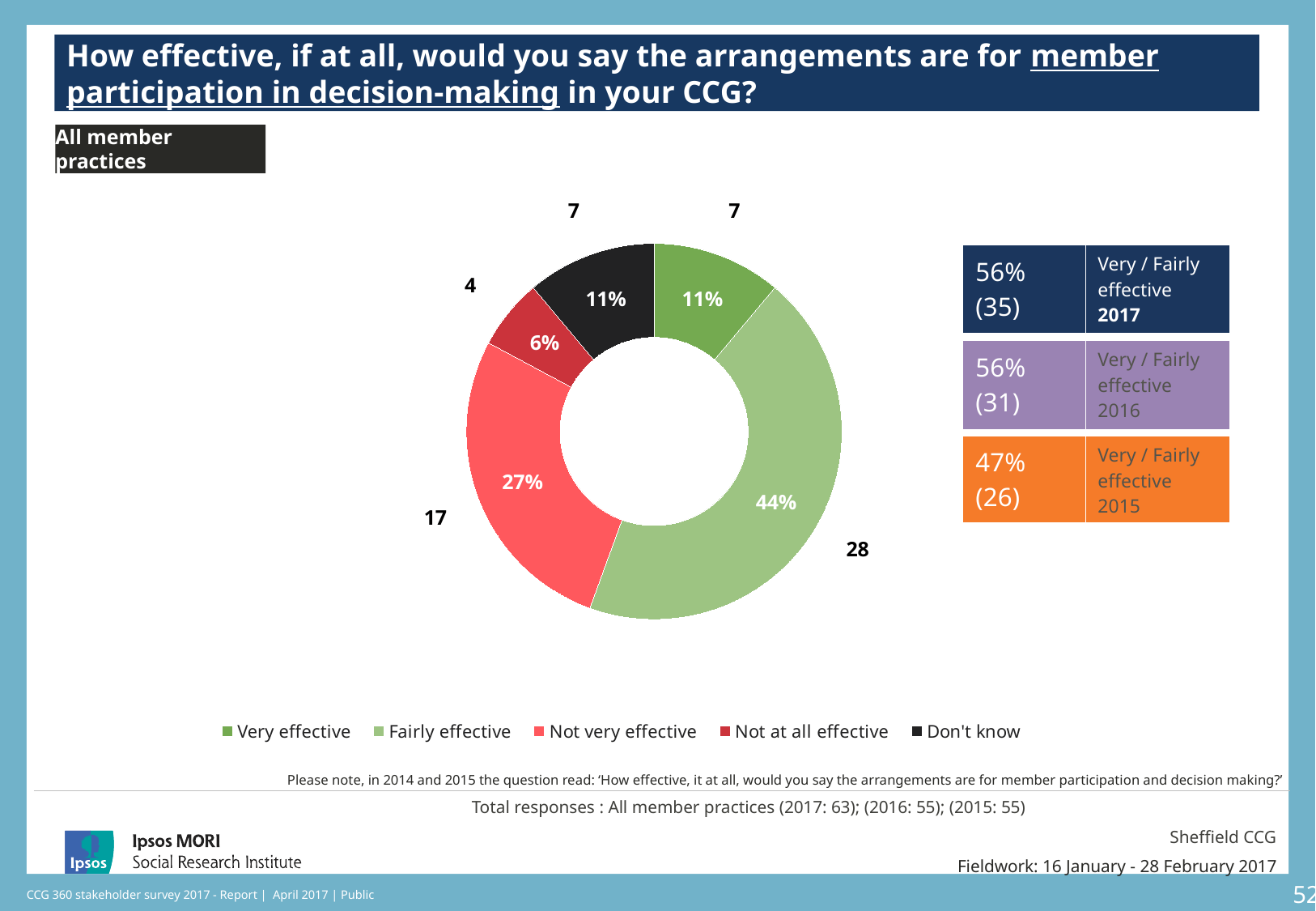
How many response categories does the legend list? 5 What percentage of respondents said the arrangements are not very effective? 27% What is the difference in percentage points between 'Fairly effective' and 'Not very effective'? 17 What colour is the 'Don't know' slice in the chart? Black How many respondents answered 'Don't know'? 7 What percentage of respondents said the arrangements are fairly effective? 44% Which is larger, the share for 'Not very effective' or the share for 'Very effective'? Not very effective What percentage of respondents said the arrangements are not at all effective? 6% How many respondents answered 'Fairly effective'? 28 Which response category has the smallest share of the chart? Not at all effective Which response category has the largest share of the chart? Fairly effective What kind of chart is shown on the slide? Donut (pie) chart